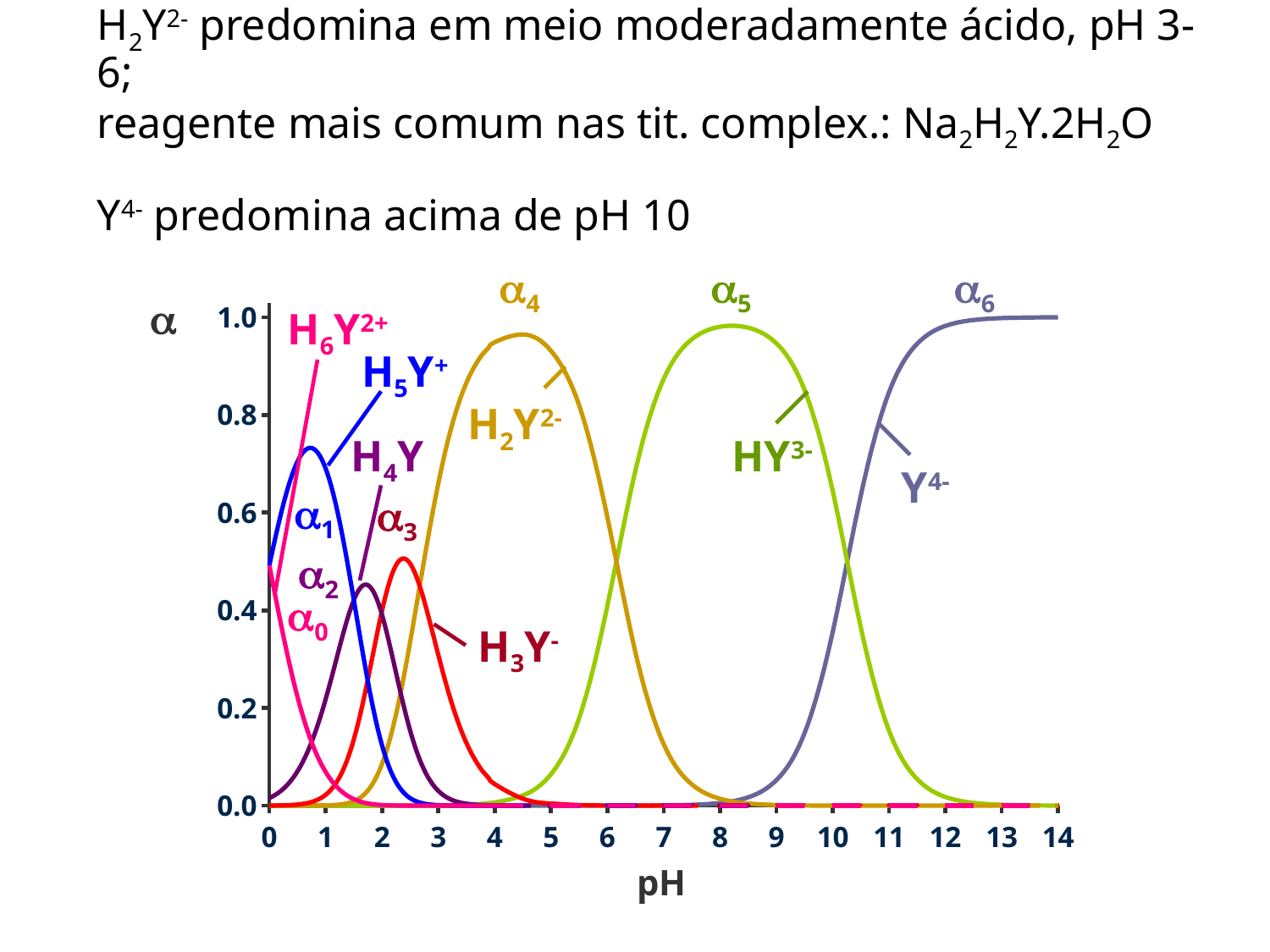
What is the label of the x axis of the chart? pH At pH 12, which curve has the larger value, Y4- or HY3-? Y4- How many species curves (α0 through α6) are plotted on the chart? 7 Is the value of the Y4- (α6) curve at pH 14 greater or less than 0.8? greater Does the Y4- (α6) curve rise or fall as pH increases? rise Is the peak value of the H3Y- (α3) curve greater or less than 0.6? less Among the curves α1, α2 and α3, which one reaches the highest peak? α1 What is the label of the y axis of the chart? α What kind of chart is shown on the slide? line chart Is the peak value of the H5Y+ (α1) curve greater or less than 0.6? greater At pH 5, which curve has the larger value, H2Y2- or HY3-? H2Y2-